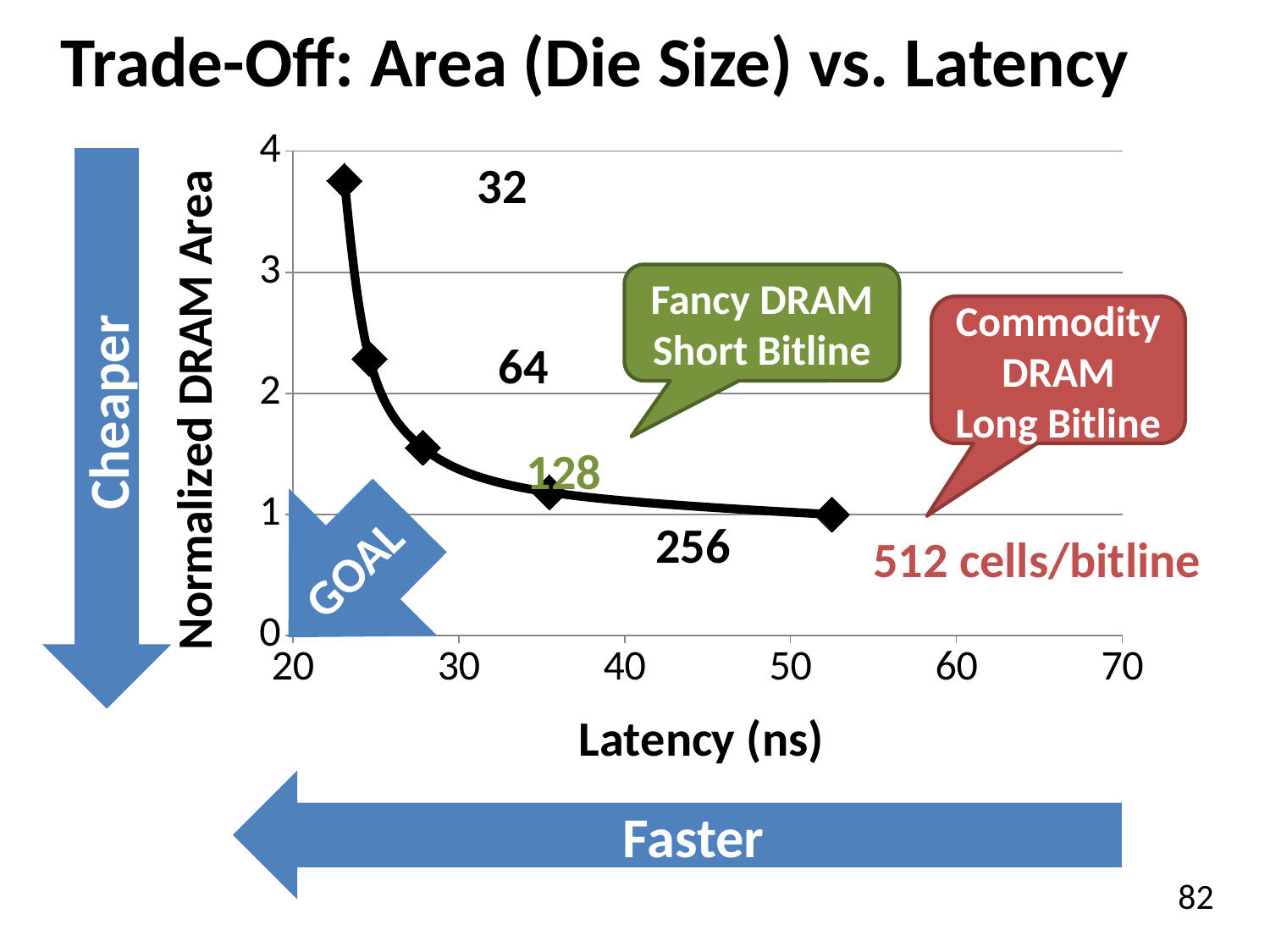
Is the latency for 512 cells/bitline greater or less than 50 ns? greater How many data points are plotted on the chart? 5 Is the normalized DRAM area for 128 cells/bitline greater or less than 2? less As latency increases along the x axis, does the normalized DRAM area rise or fall? fall Which cells/bitline configuration has the lowest latency? 32 Which cells/bitline configuration has the highest latency? 512 What kind of chart is shown on the slide? line chart What is the label of the y axis? Normalized DRAM Area Is the normalized DRAM area for 32 cells/bitline greater or less than 3? greater Which cells/bitline configuration has the highest normalized DRAM area? 32 Which has a larger normalized DRAM area, 32 cells/bitline or 64 cells/bitline? 32 cells/bitline What is the label of the x axis? Latency (ns)